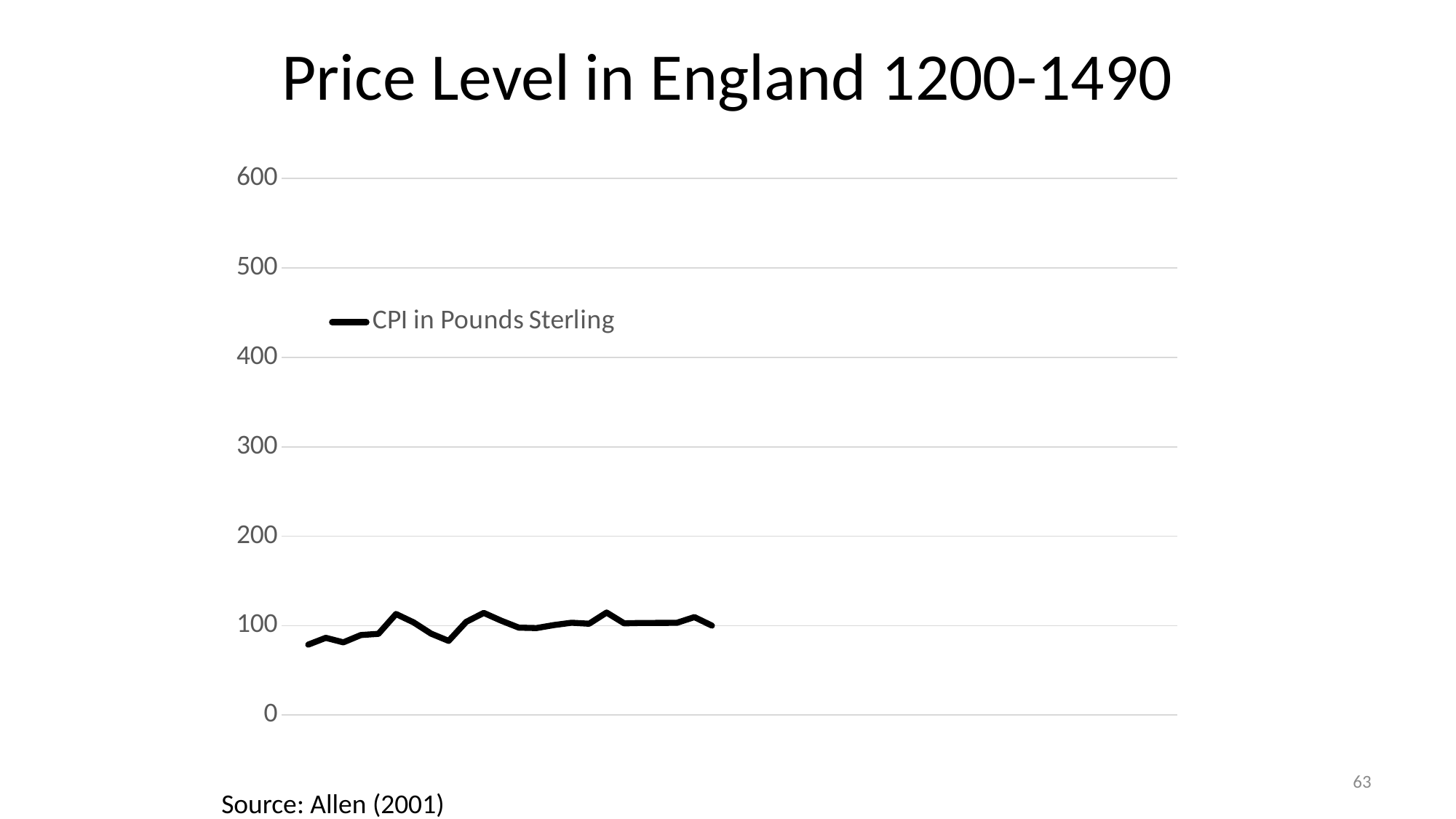
Is the highest point of the CPI in Pounds Sterling line greater or less than 300? less What is the title of the chart? Price Level in England 1200-1490 What is the name of the series shown in the legend? CPI in Pounds Sterling How many series does the legend list? 1 Is the highest point of the CPI in Pounds Sterling line greater or less than 200? less What kind of chart is shown on the slide? line chart What is the highest value shown on the vertical axis? 600 Is the last point of the CPI in Pounds Sterling line greater or less than 200? less